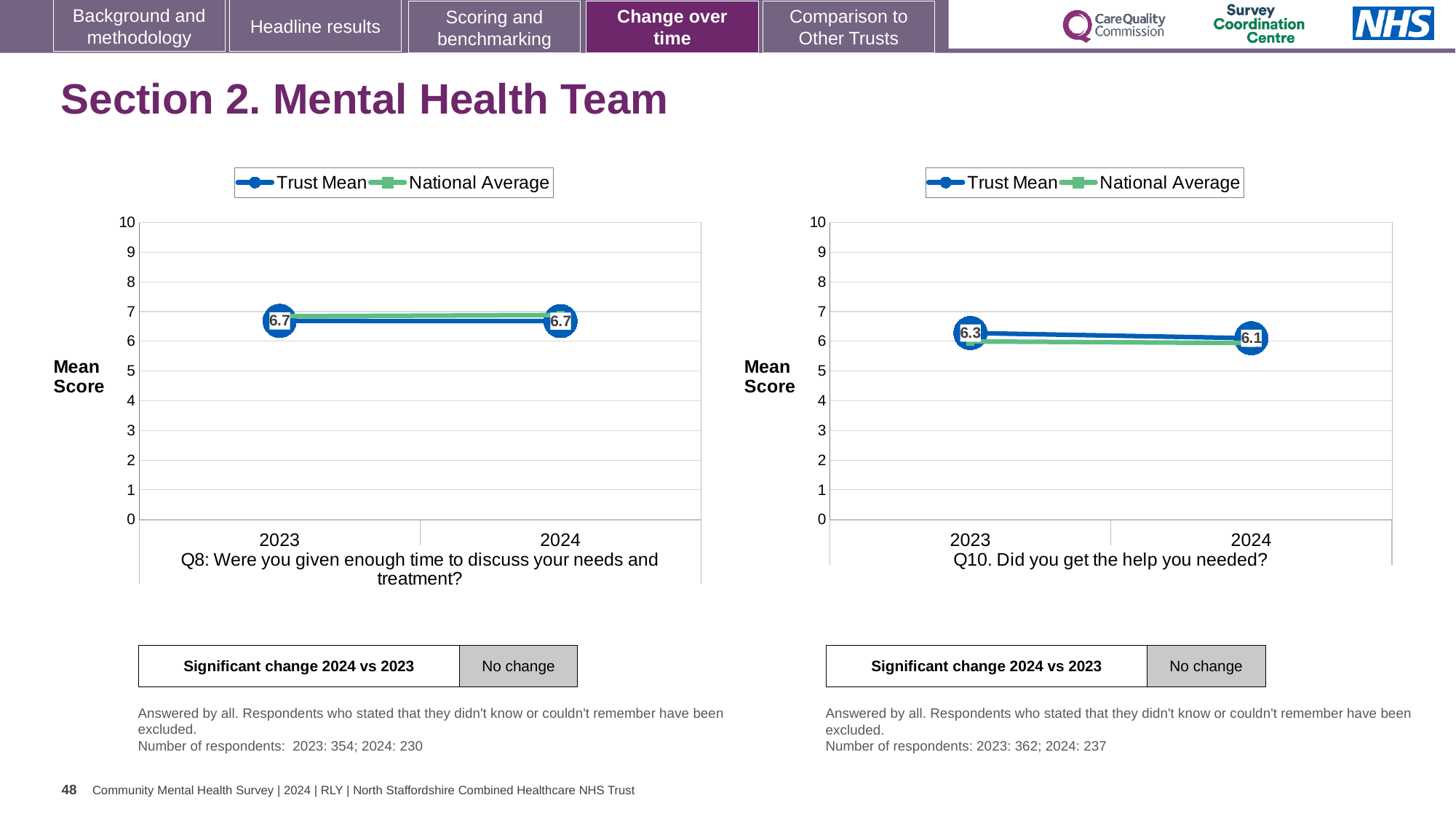
In the Q10 chart on the right, by how much did the Trust Mean change from 2023 to 2024? decreased by 0.2 In the Q10 chart on the right, what is the Trust Mean score for 2024? 6.1 In the Q8 chart on the left, what is the Trust Mean score for 2024? 6.7 How many series does the legend of the Q10 chart on the right list? 2 In the Q8 chart on the left, what is the Trust Mean score for 2023? 6.7 How many years are shown on the x axis of the Q8 chart on the left? 2 In the Q10 chart on the right, does the Trust Mean rise or fall from 2023 to 2024? fall In the Q8 chart on the left, does the Trust Mean rise, fall or stay the same from 2023 to 2024? stay the same What kind of chart is the Q8 chart on the left? line chart In the Q10 chart on the right, is the National Average value for 2024 greater or less than 7? less What is the label of the y axis on the Q8 chart on the left? Mean Score In the Q10 chart on the right, what is the Trust Mean score for 2023? 6.3